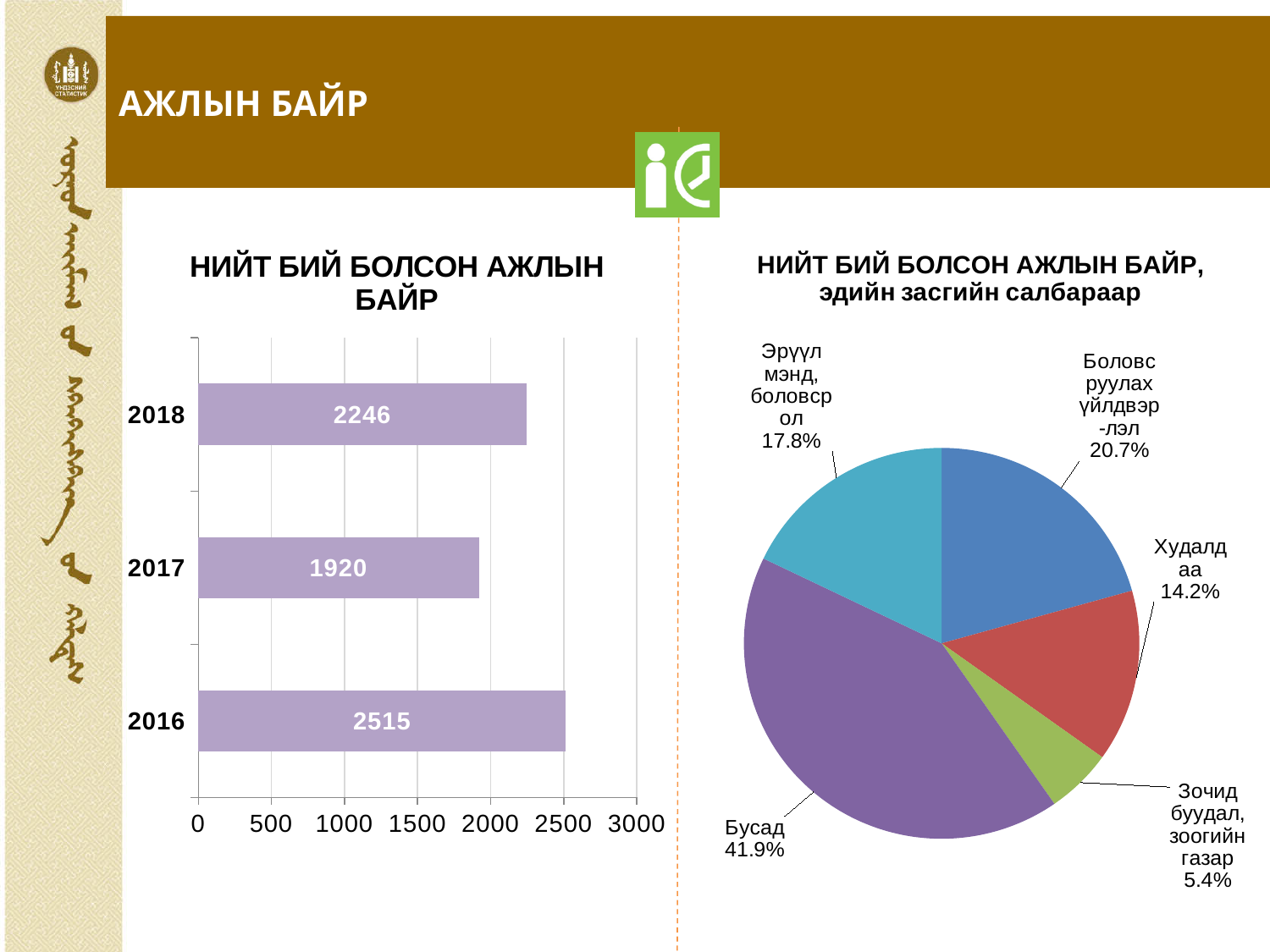
In the bar chart 'НИЙТ БИЙ БОЛСОН АЖЛЫН БАЙР', what is the value for 2017? 1920 In the bar chart 'НИЙТ БИЙ БОЛСОН АЖЛЫН БАЙР', which year has the highest value? 2016 In the bar chart 'НИЙТ БИЙ БОЛСОН АЖЛЫН БАЙР', which year has the lowest value? 2017 In the pie chart 'НИЙТ БИЙ БОЛСОН АЖЛЫН БАЙР, эдийн засгийн салбараар', what share does 'Бусад' have? 41.9% In the pie chart 'НИЙТ БИЙ БОЛСОН АЖЛЫН БАЙР, эдийн засгийн салбараар', what share does 'Худалдаа' have? 14.2% What kind of chart is the left chart 'НИЙТ БИЙ БОЛСОН АЖЛЫН БАЙР'? bar chart In the bar chart 'НИЙТ БИЙ БОЛСОН АЖЛЫН БАЙР', how many years are shown? 3 In the bar chart 'НИЙТ БИЙ БОЛСОН АЖЛЫН БАЙР', what is the value for 2018? 2246 In the bar chart 'НИЙТ БИЙ БОЛСОН АЖЛЫН БАЙР', what is the difference between the values for 2016 and 2018? 269 In the bar chart 'НИЙТ БИЙ БОЛСОН АЖЛЫН БАЙР', which is larger, the value for 2017 or the value for 2018? 2018 In the pie chart 'НИЙТ БИЙ БОЛСОН АЖЛЫН БАЙР, эдийн засгийн салбараар', how many slices are there? 5 In the pie chart 'НИЙТ БИЙ БОЛСОН АЖЛЫН БАЙР, эдийн засгийн салбараар', which sector has the smallest share? Зочид буудал, зоогийн газар